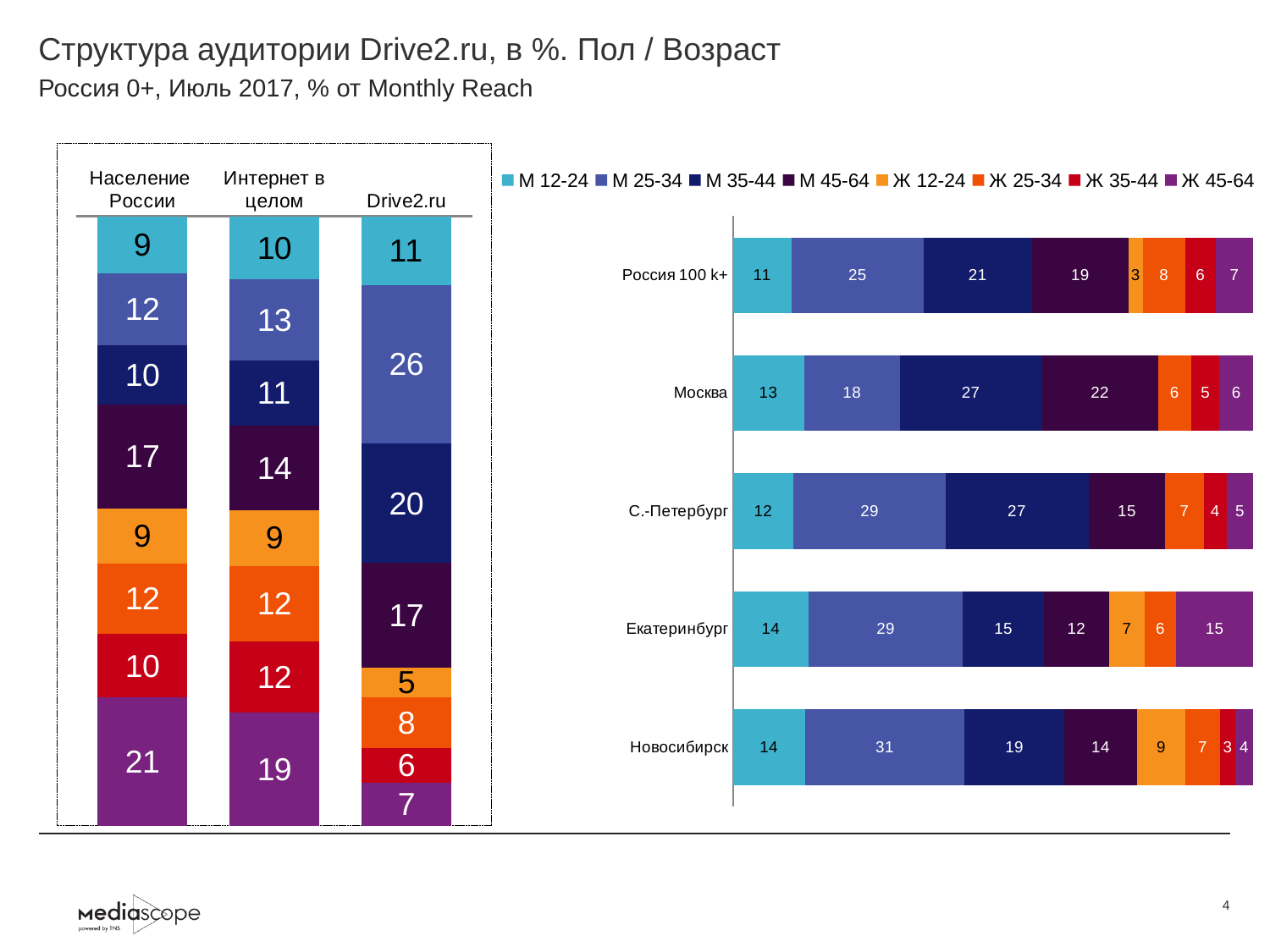
In the left chart, what is the value of the М 25-34 segment for Drive2.ru? 26 In the right chart, which is larger: the М 35-44 value for Москва or for Екатеринбург? Москва In the right chart, which city has the highest value for М 25-34? Новосибирск In the right chart, what is the value of the М 35-44 segment for Москва? 27 In the right chart, what is the value of the М 25-34 segment for Новосибирск? 31 What is the total of the Drive2.ru bar in the left chart? 100 In the left chart, which segment is the smallest in the Drive2.ru bar? Ж 12-24 How many series does the legend list? 8 In the left chart, which segment is the largest in the Drive2.ru bar? М 25-34 How many bars are in the right chart? 5 In the left chart, what is the difference between the М 25-34 values for Drive2.ru and Интернет в целом? 13 In the left chart, what is the value of the Ж 45-64 segment for Население России? 21